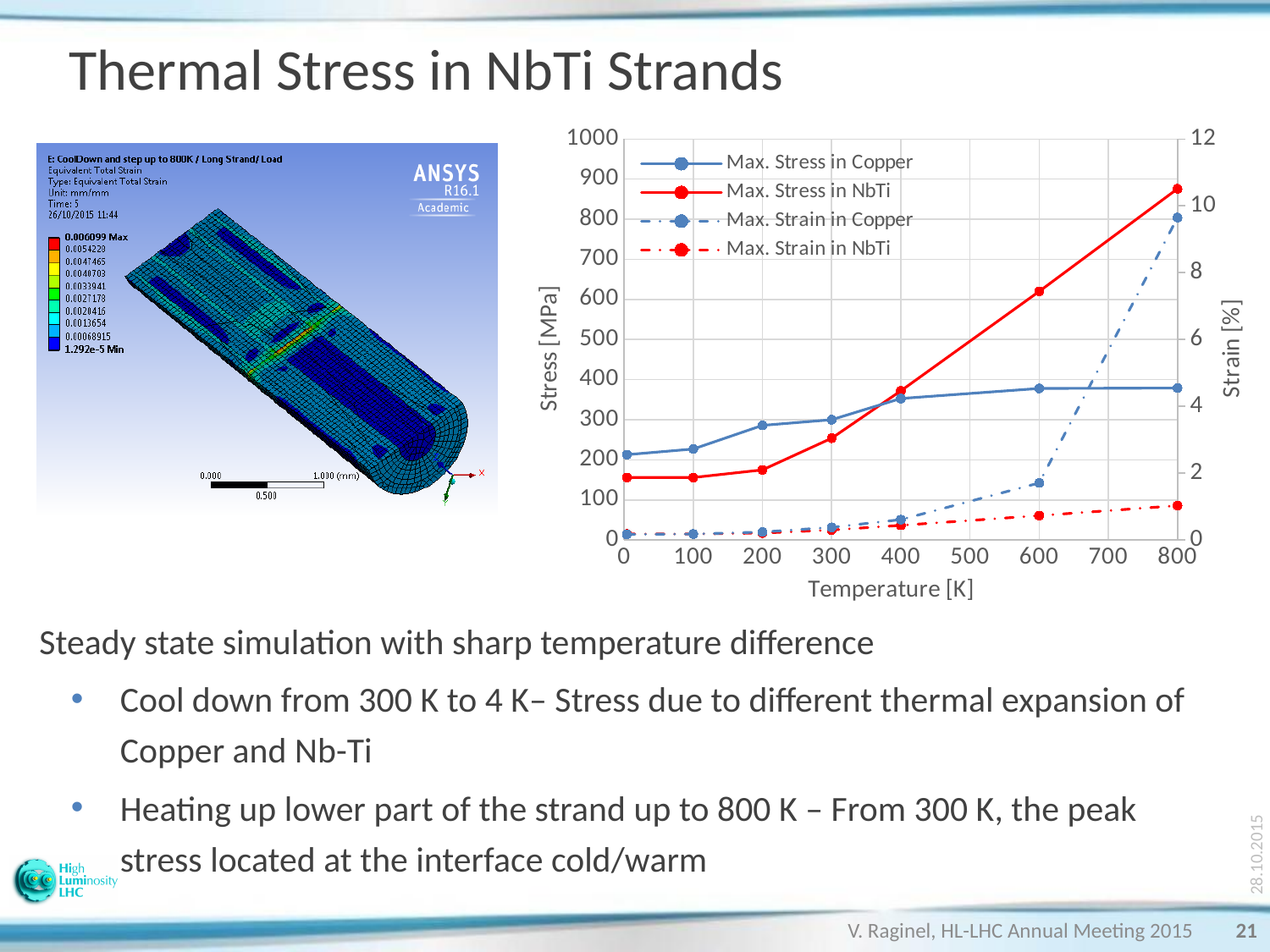
At 100 K, which is larger: Max. Stress in Copper or Max. Stress in NbTi? Max. Stress in Copper What is the title of the x axis of the chart? Temperature [K] Is the value of Max. Strain in Copper at 800 K greater or less than 8%? greater At 800 K, which is larger: Max. Stress in NbTi or Max. Stress in Copper? Max. Stress in NbTi What kind of chart is shown on the right of the slide? line chart At which temperature does Max. Stress in NbTi reach its highest value? 800 K What is the title of the right-hand y axis of the chart? Strain [%] Is the value of Max. Stress in NbTi at 800 K greater or less than 800 MPa? greater Does Max. Stress in NbTi rise or fall as temperature increases from 200 K to 800 K? rise Is the value of Max. Stress in Copper at 800 K greater or less than 400 MPa? less How many series does the legend of the chart list? 4